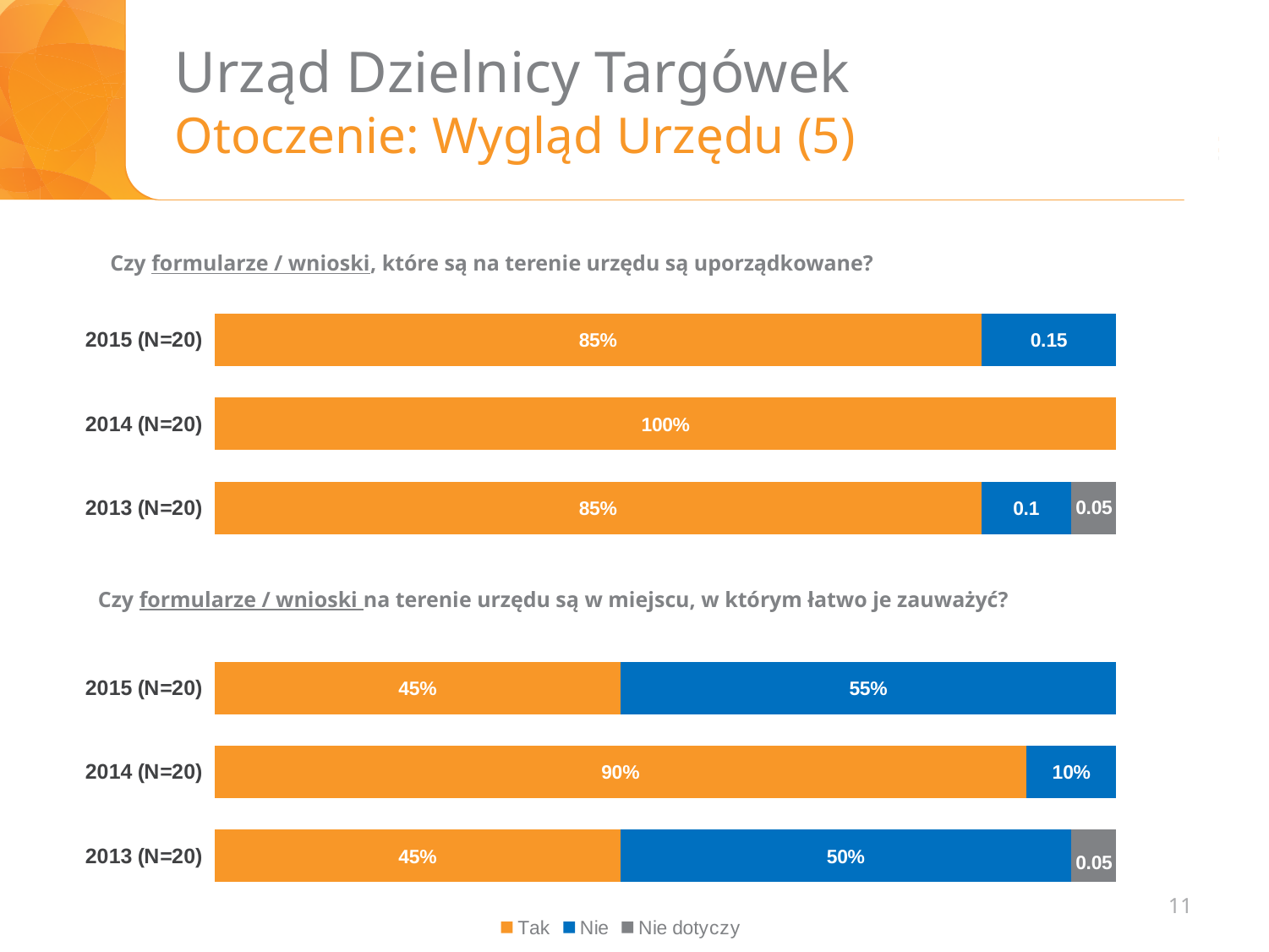
In the top chart, what is the 'Nie' value for 2015 (N=20)? 0.15 In the top chart, what is the 'Tak' value for 2015 (N=20)? 85% In the bottom chart, which year has the lowest 'Nie' value? 2014 (N=20) In the top chart, what is the 'Tak' value for 2014 (N=20)? 100% In the bottom chart, what is the 'Tak' value for 2014 (N=20)? 90% In the bottom chart, what is the 'Nie' value for 2013 (N=20)? 50% In the bottom chart, is the 'Tak' value for 2015 (N=20) larger or smaller than the 'Nie' value for 2015 (N=20)? smaller In the top chart, which year has the highest 'Tak' value? 2014 (N=20) In the top chart, what is the 'Nie dotyczy' value for 2013 (N=20)? 0.05 In the bottom chart, what is the difference between the 'Tak' values for 2014 (N=20) and 2015 (N=20)? 45% In the bottom chart, what is the 'Nie' value for 2015 (N=20)? 55% How many series does the legend at the bottom of the slide list? 3